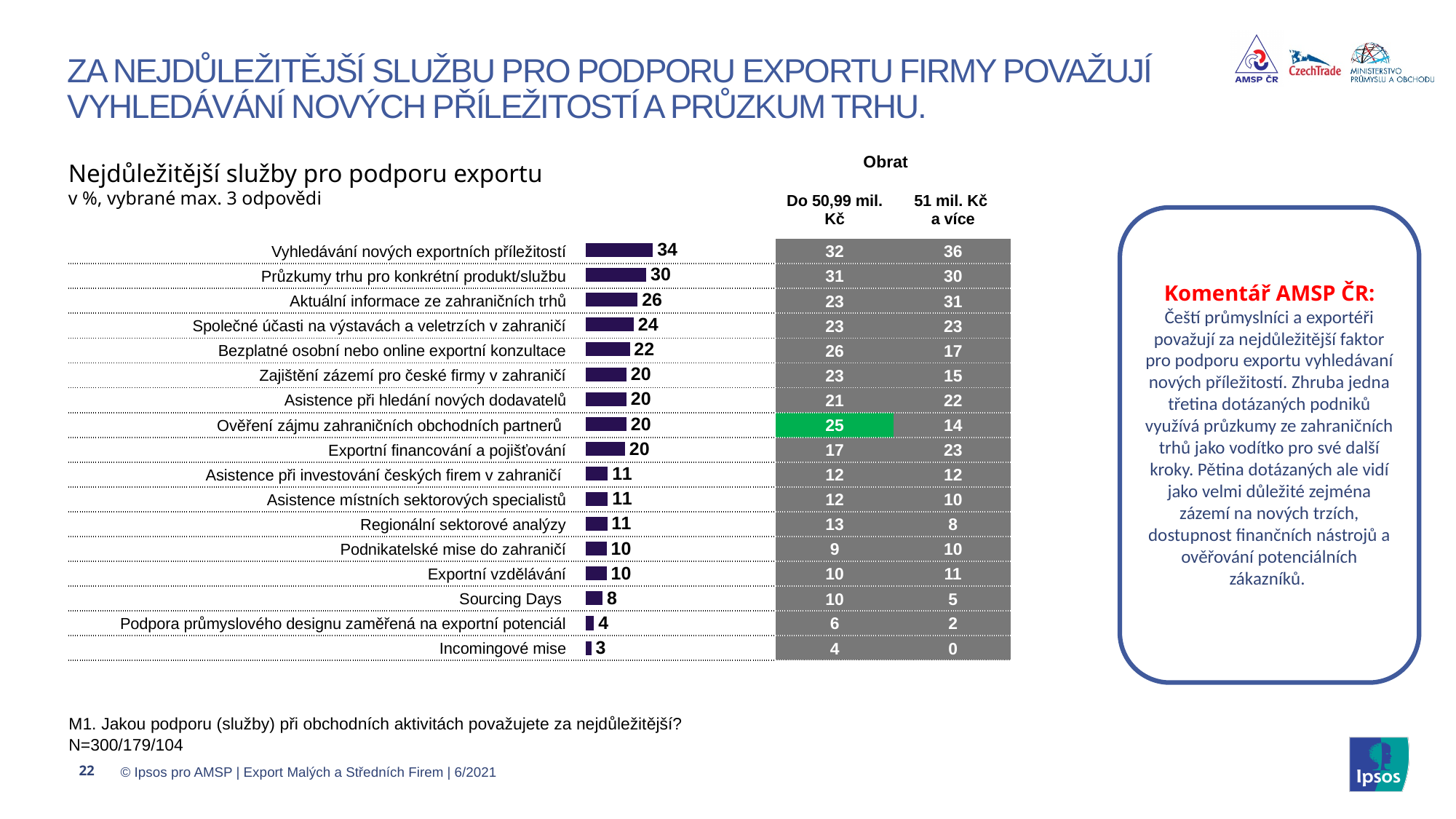
Which is larger: the value for "Bezplatné osobní nebo online exportní konzultace" or for "Společné účasti na výstavách a veletrzích v zahraničí"? Společné účasti na výstavách a veletrzích v zahraničí How many categories are shown in the bar chart? 17 What is the title of the chart? Nejdůležitější služby pro podporu exportu What is the value for "Průzkumy trhu pro konkrétní produkt/službu" in the bar chart? 30 What is the difference between the values for "Vyhledávání nových exportních příležitostí" and "Aktuální informace ze zahraničních trhů"? 8 Which category has the lowest value in the bar chart? Incomingové mise What is the value for "Vyhledávání nových exportních příležitostí" in the bar chart? 34 What is the value for "Sourcing Days" in the bar chart? 8 What is the difference between the values for "Podnikatelské mise do zahraničí" and "Podpora průmyslového designu zaměřená na exportní potenciál"? 6 What type of chart is shown on the slide? Bar chart What is the value for "Exportní financování a pojišťování" in the bar chart? 20 Which category has the highest value in the bar chart? Vyhledávání nových exportních příležitostí